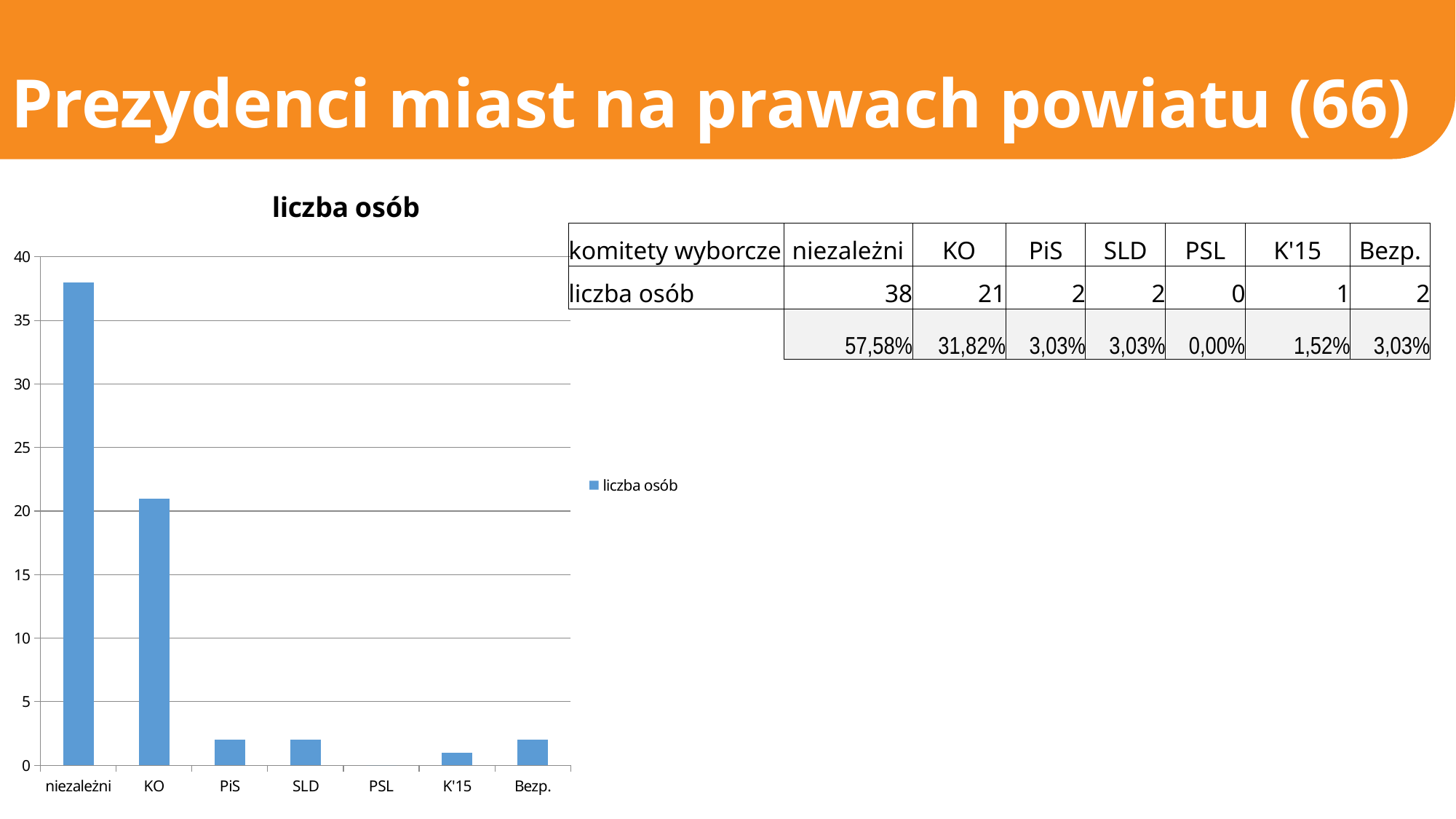
Which category has the lowest value in the chart? PSL What is the value for K'15? 1 What is the difference between the values for niezależni and KO? 17 How many series does the chart legend list? 1 What is the value for KO? 21 What type of chart is shown on the slide? bar chart Which is larger, the value for KO or the value for PiS? KO What is the value for niezależni? 38 What is the title of the chart? liczba osób Which category has the highest value in the chart? niezależni Is the value for niezależni greater or less than 35? greater How many categories are shown on the x axis of the chart? 7